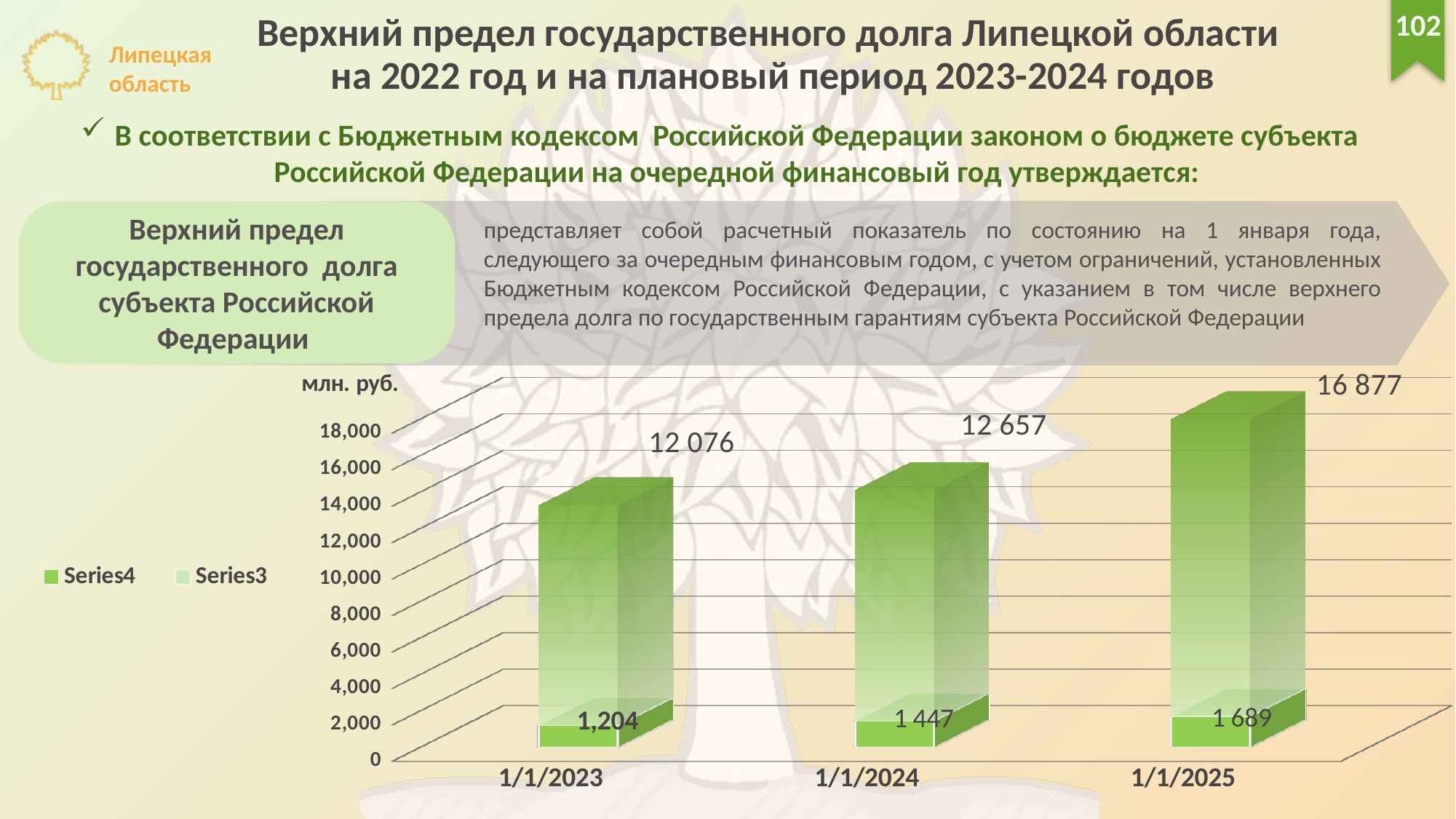
Which date has the lowest value labelled on the lower segment of its bar? 1/1/2023 What unit is written above the vertical axis of the chart? млн. руб. How many dates are shown on the x axis of the chart? 3 What kind of chart is shown on the slide? bar chart How many series does the chart legend list? 2 What value is labelled on the lower segment of the bar for 1/1/2025? 1 689 What value is labelled above the bar for 1/1/2023? 12 076 Which date has the highest value labelled above its bar? 1/1/2025 Do the values labelled above the bars rise or fall from 1/1/2023 to 1/1/2025? rise What value is labelled above the bar for 1/1/2025? 16 877 What is the difference between the values labelled above the bars for 1/1/2025 and 1/1/2024? 4 220 What value is labelled on the lower segment of the bar for 1/1/2023? 1,204